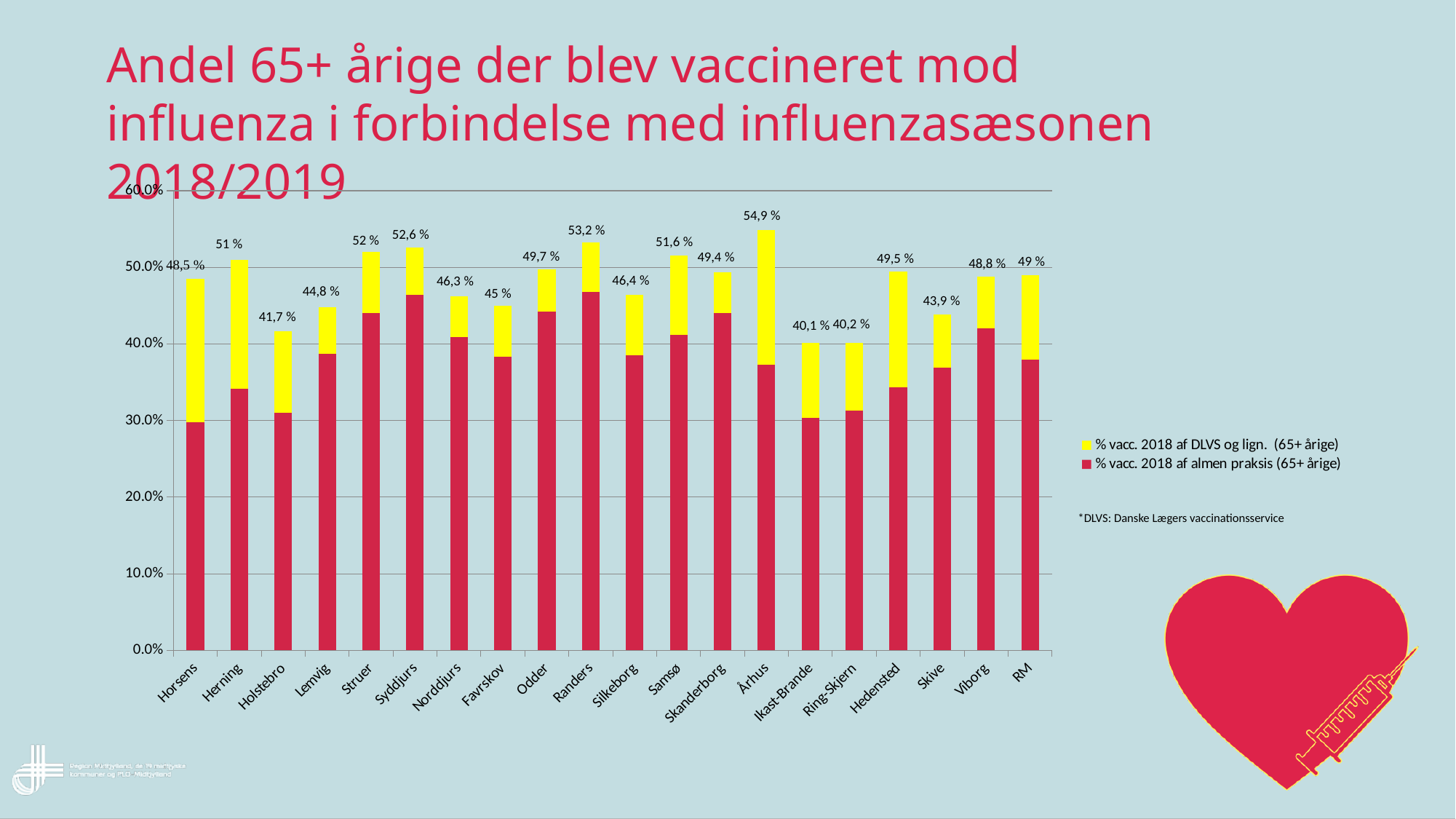
Is the red (almen praksis) segment for Randers greater or less than 40.0%? greater What is the total labelled value for Århus? 54,9 % How many categories are shown on the x axis? 20 What is the total labelled value for Holstebro? 41,7 % Which category has the lowest total value? Ikast-Brande Is the red (almen praksis) segment for Århus greater or less than 40.0%? less What is the difference between the total values for Århus and Ikast-Brande? 14,8 percentage points What is the total labelled value for RM? 49 % Which has a higher total value, Randers or Horsens? Randers What kind of chart is shown on the slide? Stacked bar chart Which category has the highest total value? Århus How many series does the legend list? 2